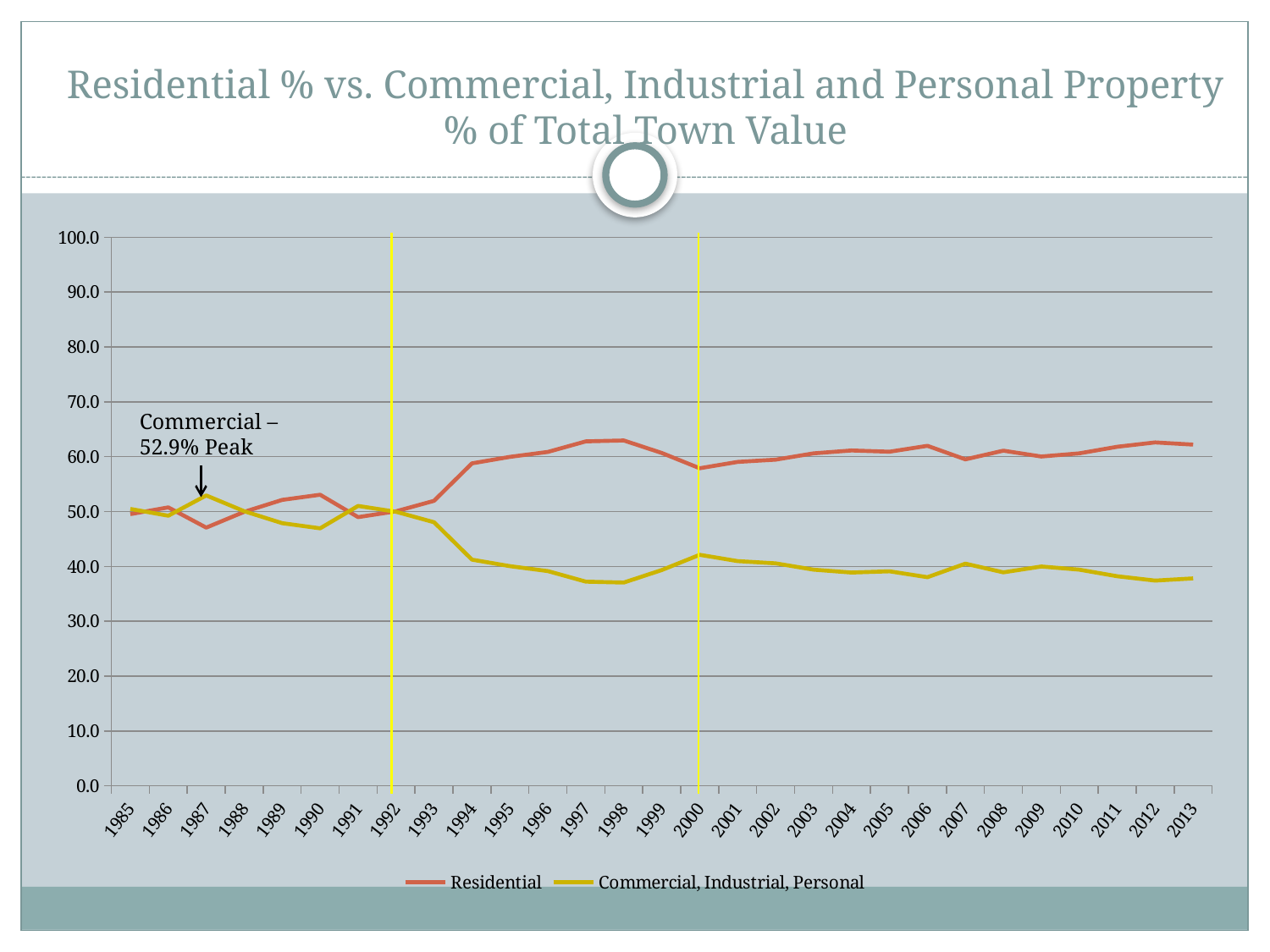
Is the Residential value in 1987 greater or less than 50.0? less How many series does the legend list? 2 Is the Commercial, Industrial, Personal value in 1998 greater or less than 40.0? less What is the first year shown on the x axis? 1985 Does the Commercial, Industrial, Personal line rise or fall between 1993 and 1998? fall In which year does the annotation mark the Commercial peak of 52.9%? 1987 What kind of chart is shown on the slide? line chart Is the Residential value in 2013 greater or less than 60.0? greater What peak value does the annotation give for the Commercial series? 52.9% Which series has the higher value in 2013, Residential or Commercial, Industrial, Personal? Residential How many years are plotted along the x axis? 29 Does the Residential line rise or fall between 1992 and 1997? rise